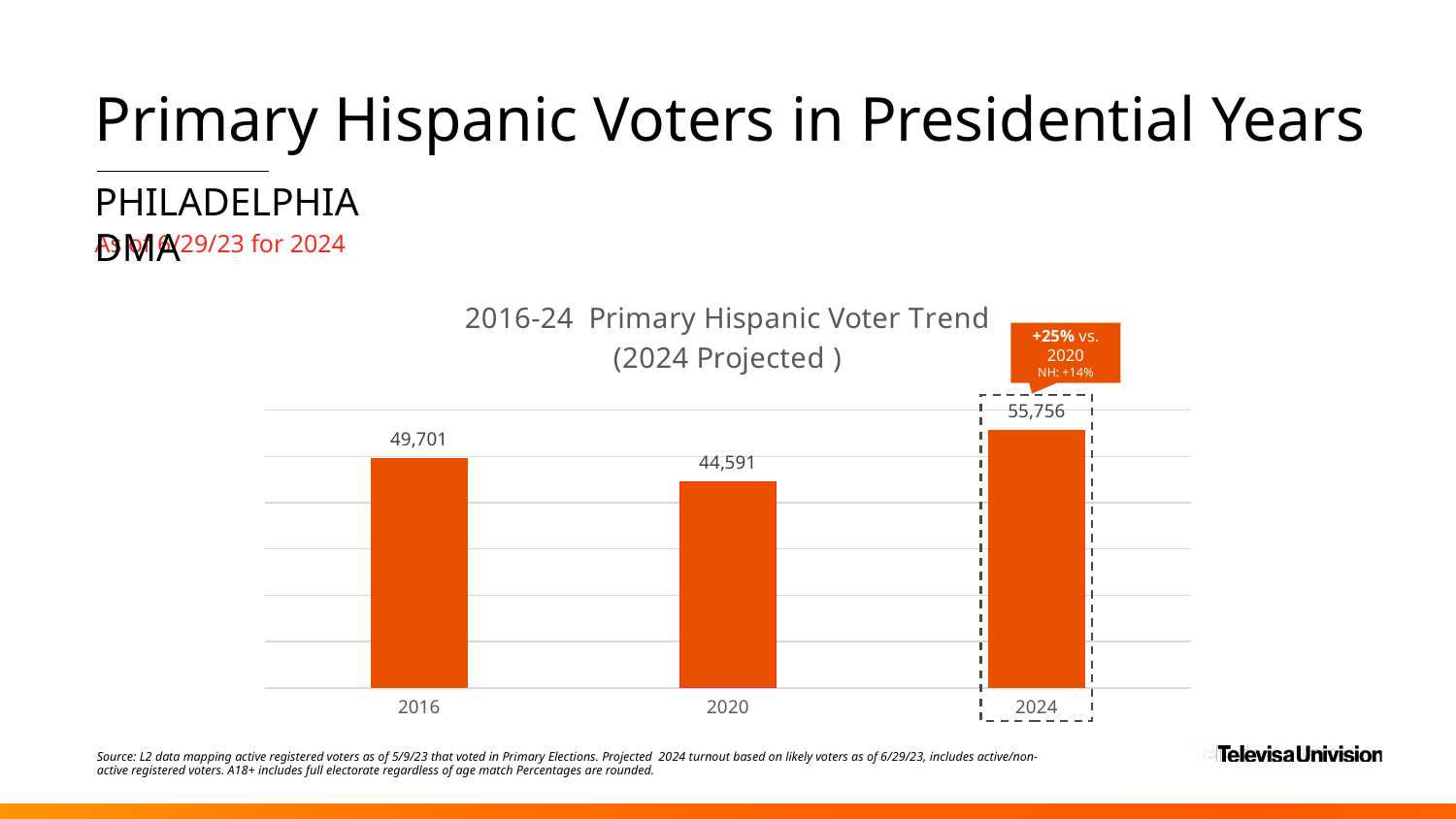
According to the callout on the 2016-24 Primary Hispanic Voter Trend chart, what is the percentage change for 2024 vs. 2020? +25% What is the value for 2016 in the 2016-24 Primary Hispanic Voter Trend chart? 49,701 What is the difference between the 2016 and 2020 values in the 2016-24 Primary Hispanic Voter Trend chart? 5,110 What kind of chart is the 2016-24 Primary Hispanic Voter Trend chart? Bar chart How many years are shown on the x axis of the 2016-24 Primary Hispanic Voter Trend chart? 3 What is the value for 2020 in the 2016-24 Primary Hispanic Voter Trend chart? 44,591 Which year has the lowest value in the 2016-24 Primary Hispanic Voter Trend chart? 2020 Which year's bar is outlined with a dashed box in the 2016-24 Primary Hispanic Voter Trend chart? 2024 What is the projected value for 2024 in the 2016-24 Primary Hispanic Voter Trend chart? 55,756 What is the difference between the 2024 and 2020 values in the 2016-24 Primary Hispanic Voter Trend chart? 11,165 Which year has the highest value in the 2016-24 Primary Hispanic Voter Trend chart? 2024 Which is larger in the 2016-24 Primary Hispanic Voter Trend chart, the value for 2016 or the value for 2020? 2016